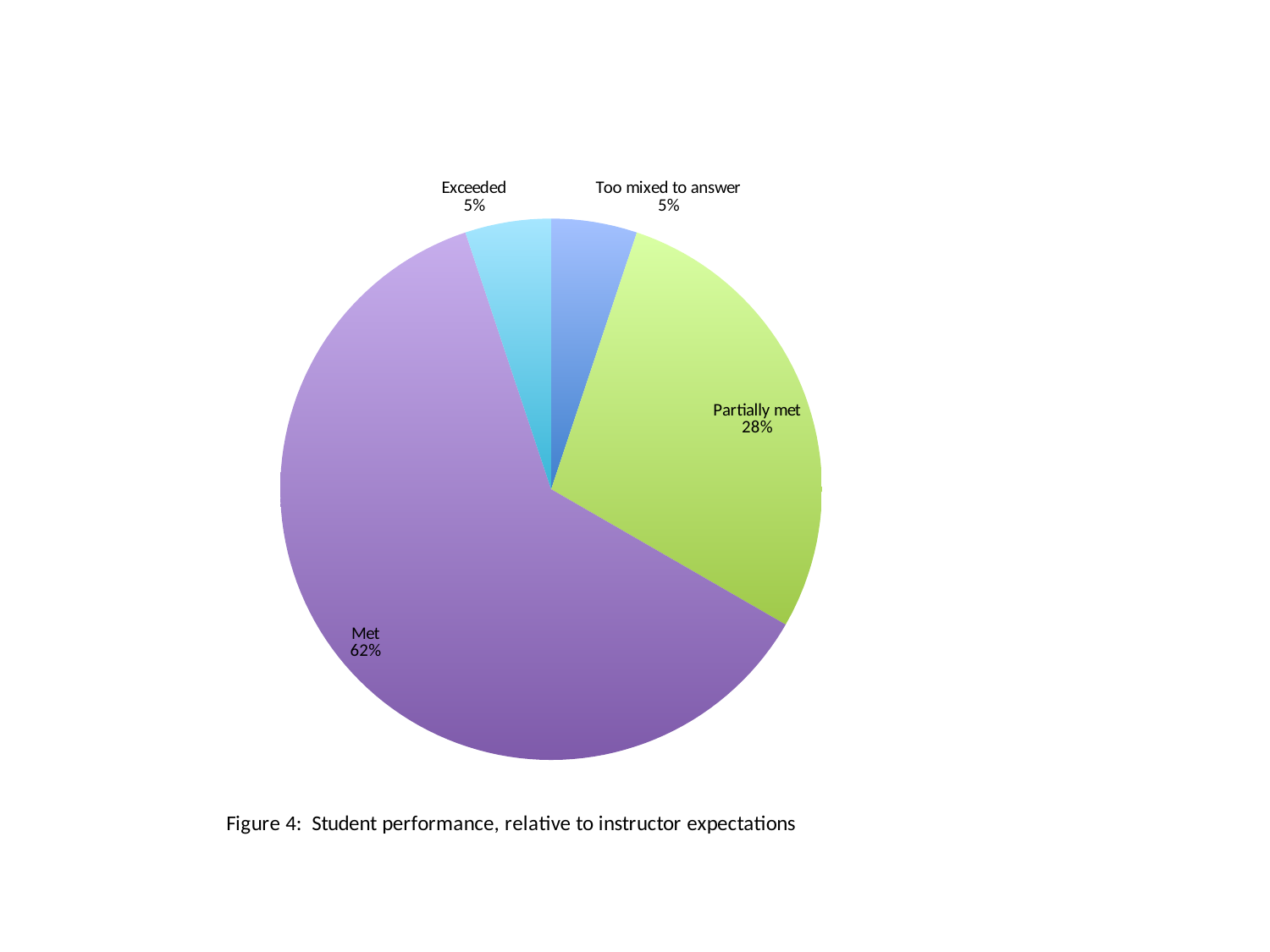
How many slices does the pie chart have? 4 What colour is the "Met" slice of the pie? purple Which slice is larger, "Partially met" or "Exceeded"? Partially met Which category has the largest slice of the pie? Met What is the caption of the figure shown on the slide? Figure 4: Student performance, relative to instructor expectations What is the combined share of the "Exceeded" and "Too mixed to answer" slices? 10% What share of the pie is labelled "Partially met"? 28% What share of the pie is labelled "Exceeded"? 5% What share of the pie is labelled "Too mixed to answer"? 5% What kind of chart is shown on the slide? pie chart What is the difference in percentage points between the "Met" and "Partially met" slices? 34